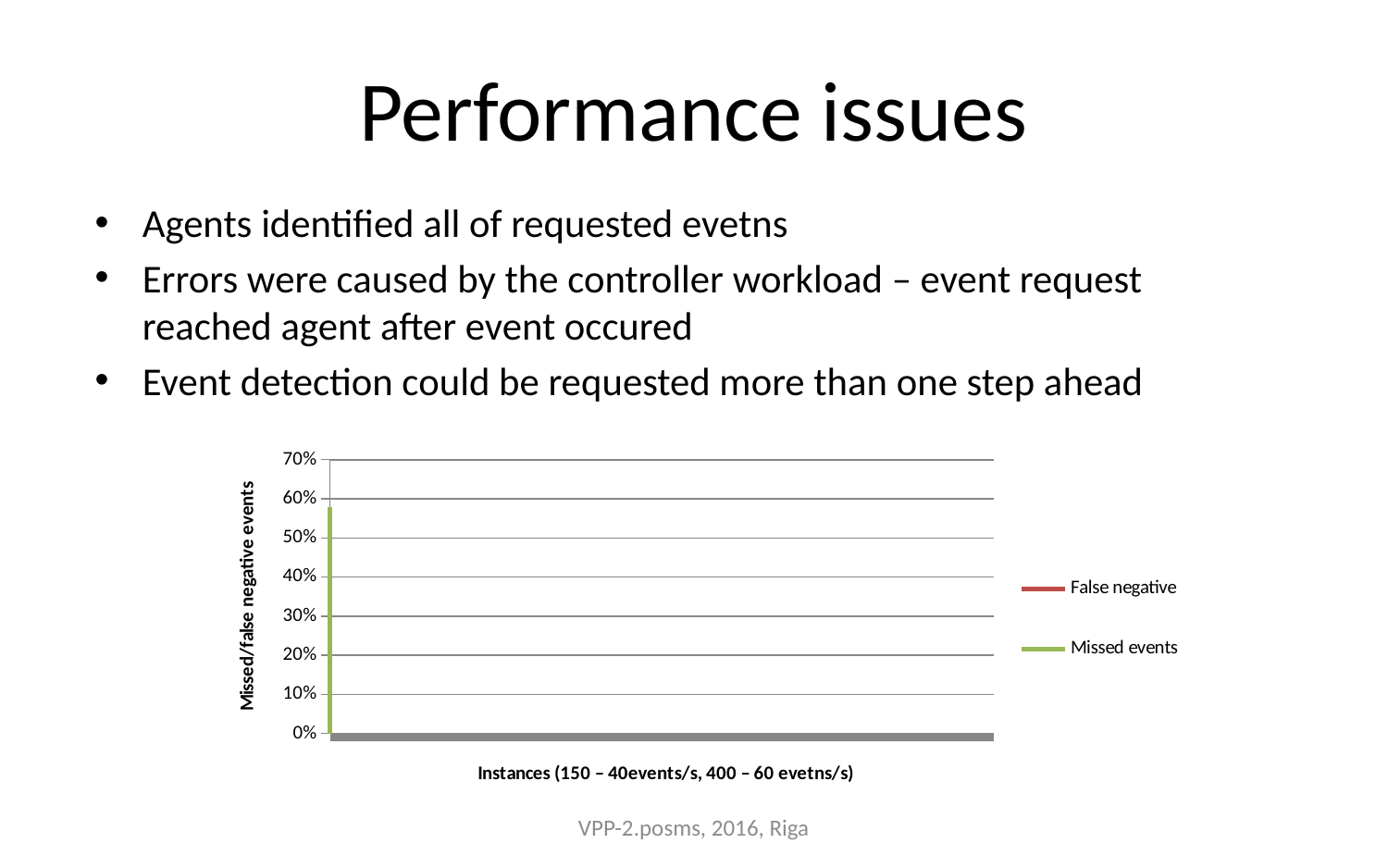
Is the peak value of the Missed events series greater or less than 50%? greater What are the two series named in the chart legend? False negative and Missed events How many series does the chart legend list? 2 What is the title of the chart's vertical axis? Missed/false negative events Which series reaches the highest value on the chart? Missed events Which series has the lower values across the chart, False negative or Missed events? False negative